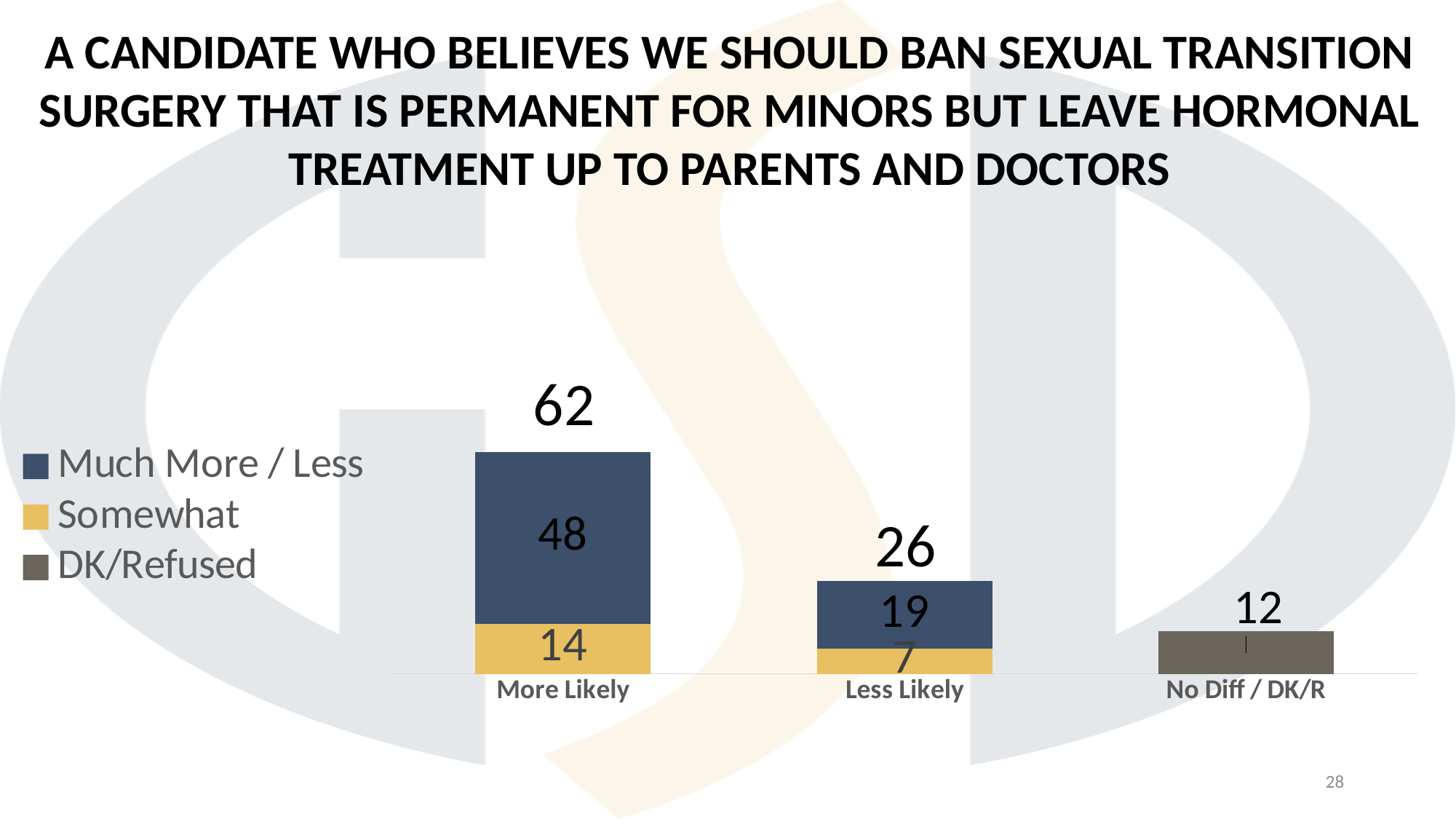
How many categories are shown on the x axis? 3 What is the 'Somewhat' value for the Less Likely bar? 7 Which is larger: the 'Somewhat' value for More Likely or for Less Likely? More Likely What is the difference between the 'Much More / Less' values for More Likely and Less Likely? 29 Which category has the highest total? More Likely Which category has the lowest total? No Diff / DK/R What is the total shown above the Less Likely stacked bar? 26 What is the 'Much More / Less' value for the More Likely bar? 48 What is the total shown above the More Likely stacked bar? 62 How many series does the legend list? 3 What is the value shown for the No Diff / DK/R bar? 12 What kind of chart is shown on the slide? Stacked bar chart